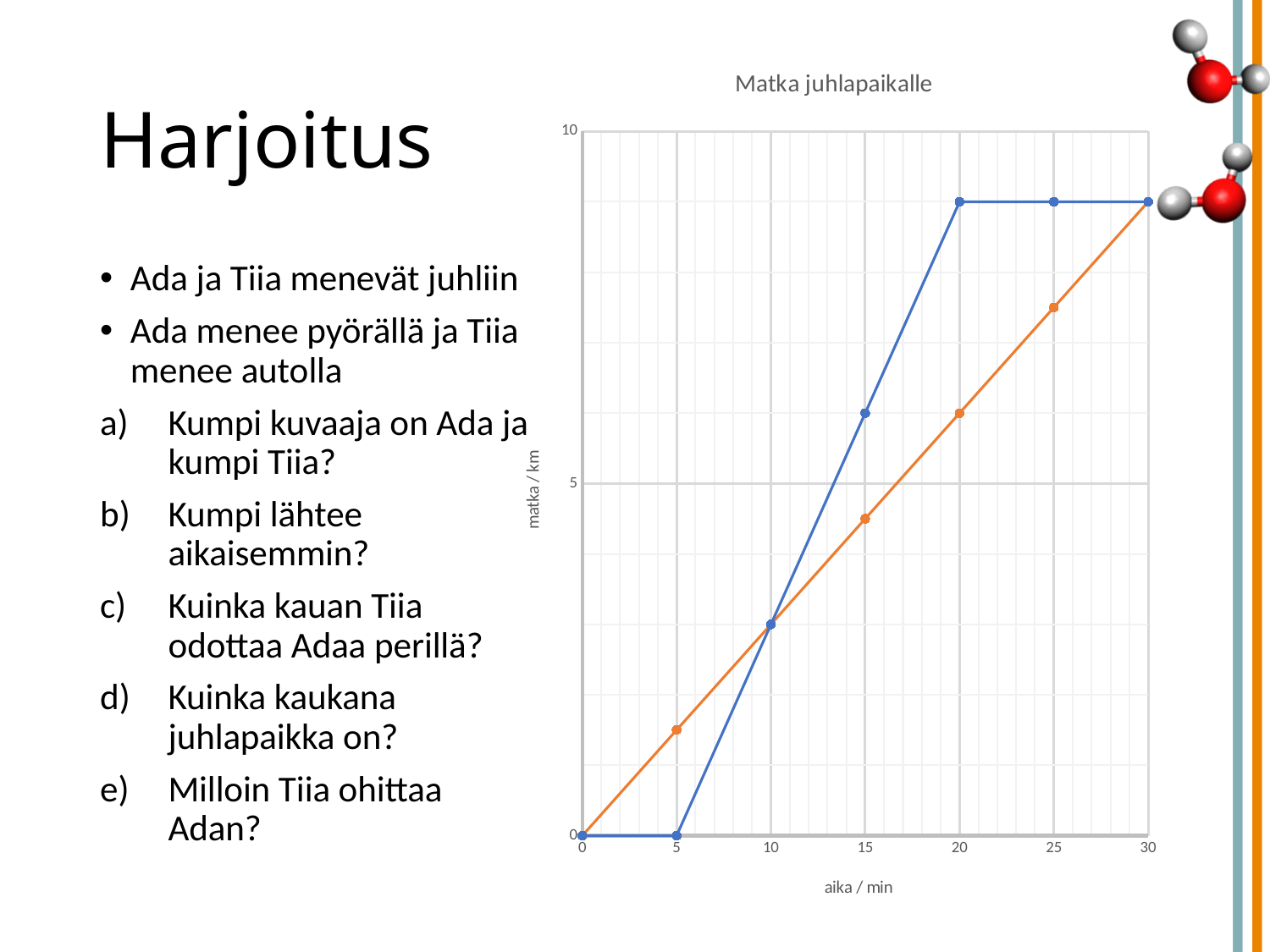
Is the value of the orange line at 25 min greater or less than 5? greater What is the value of the blue line at 5 min? 0 What is the label of the x axis of the chart? aika / min What is the title of the chart? Matka juhlapaikalle At 5 min, which line has the higher value, blue or orange? orange Is the value of the blue line at 10 min greater or less than 5? less Is the value of the blue line at 20 min greater or less than 5? greater At 15 min, which line has the higher value, blue or orange? blue What kind of chart is shown on the slide? line chart How many lines are plotted on the chart? 2 How many data points does the blue line have? 7